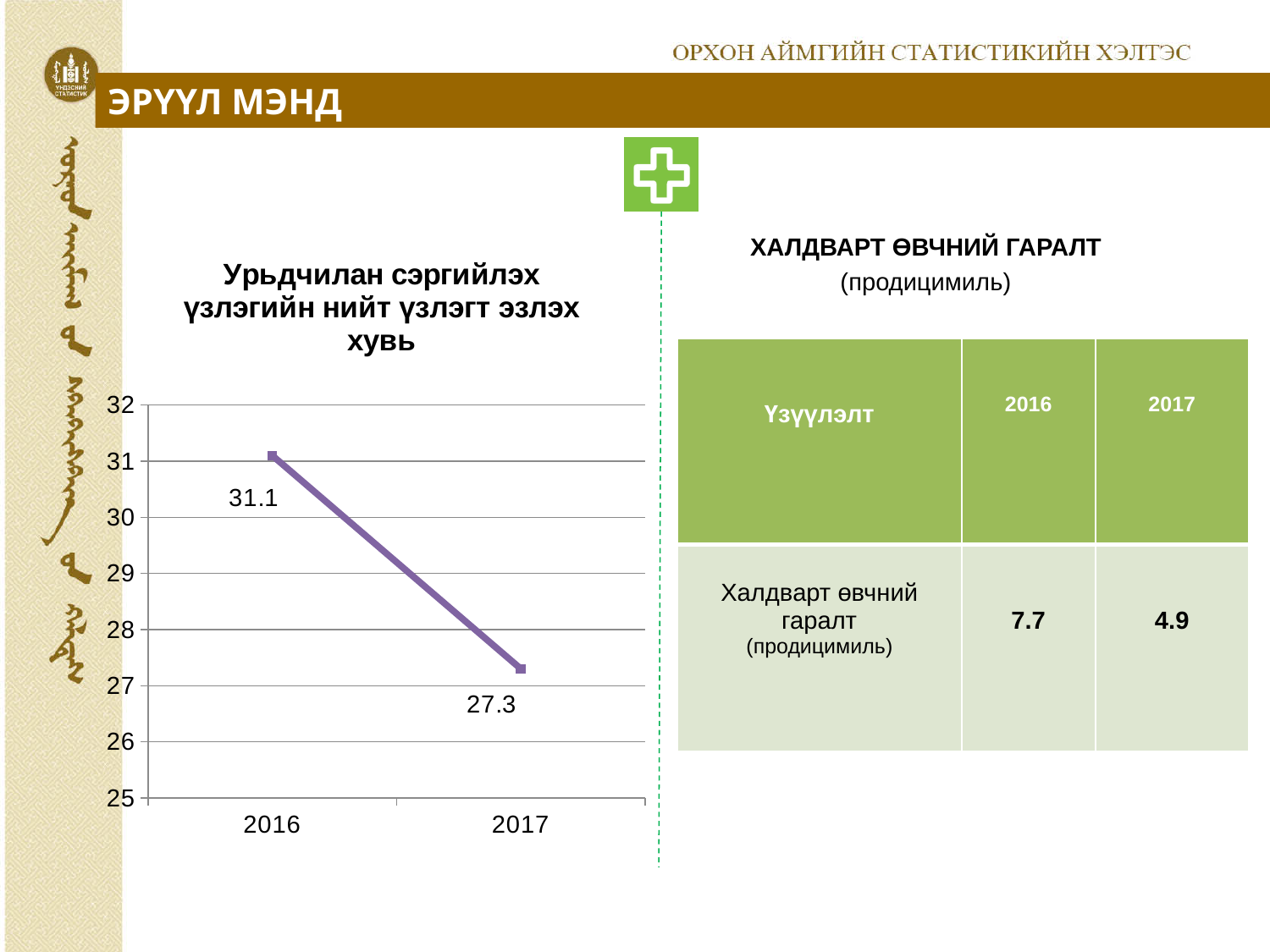
What type of chart is shown on the slide? line chart Is the value for 2017 in the line chart greater or less than 28? less What is the value for 2017 in the line chart? 27.3 What is the difference between the 2016 and 2017 values in the line chart? 3.8 What is the title of the line chart? Урьдчилан сэргийлэх үзлэгийн нийт үзлэгт эзлэх хувь Which year has the higher value in the line chart? 2016 How many data points are plotted in the line chart? 2 Is the value for 2016 larger or smaller than the value for 2017 in the line chart? larger Is the value for 2016 in the line chart greater or less than 30? greater Does the value in the line chart rise or fall from 2016 to 2017? fall Which year has the lower value in the line chart? 2017 What is the value for 2016 in the line chart? 31.1